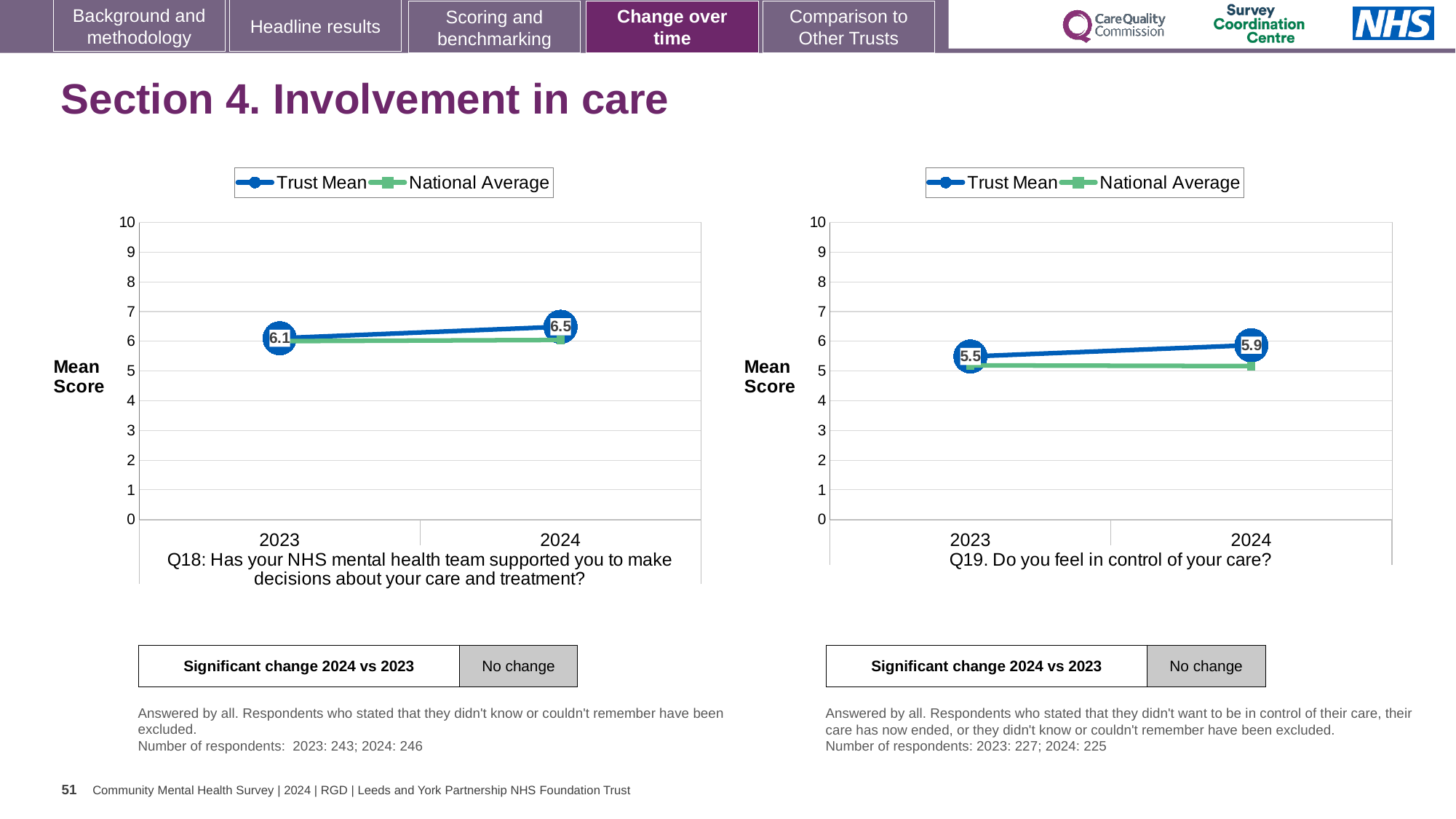
In the Q19 chart on the right, is the National Average value for 2024 greater or less than 6? less In the Q19 chart on the right, what is the Trust Mean score for 2024? 5.9 How many years are shown on the x axis of the Q18 chart on the left? 2 In the Q18 chart on the left, by how much did the Trust Mean change from 2023 to 2024? 0.4 What is the label on the y axis of the Q18 chart on the left? Mean Score In the Q19 chart on the right, which is larger in 2024, the Trust Mean or the National Average? Trust Mean How many series does the legend of the Q19 chart on the right list? 2 In the Q18 chart on the left, what is the Trust Mean score for 2024? 6.5 In the Q19 chart on the right, what is the Trust Mean score for 2023? 5.5 What type of chart is the Q18 chart on the left? line chart In the Q19 chart on the right, does the Trust Mean rise or fall from 2023 to 2024? rise In the Q18 chart on the left, what is the Trust Mean score for 2023? 6.1